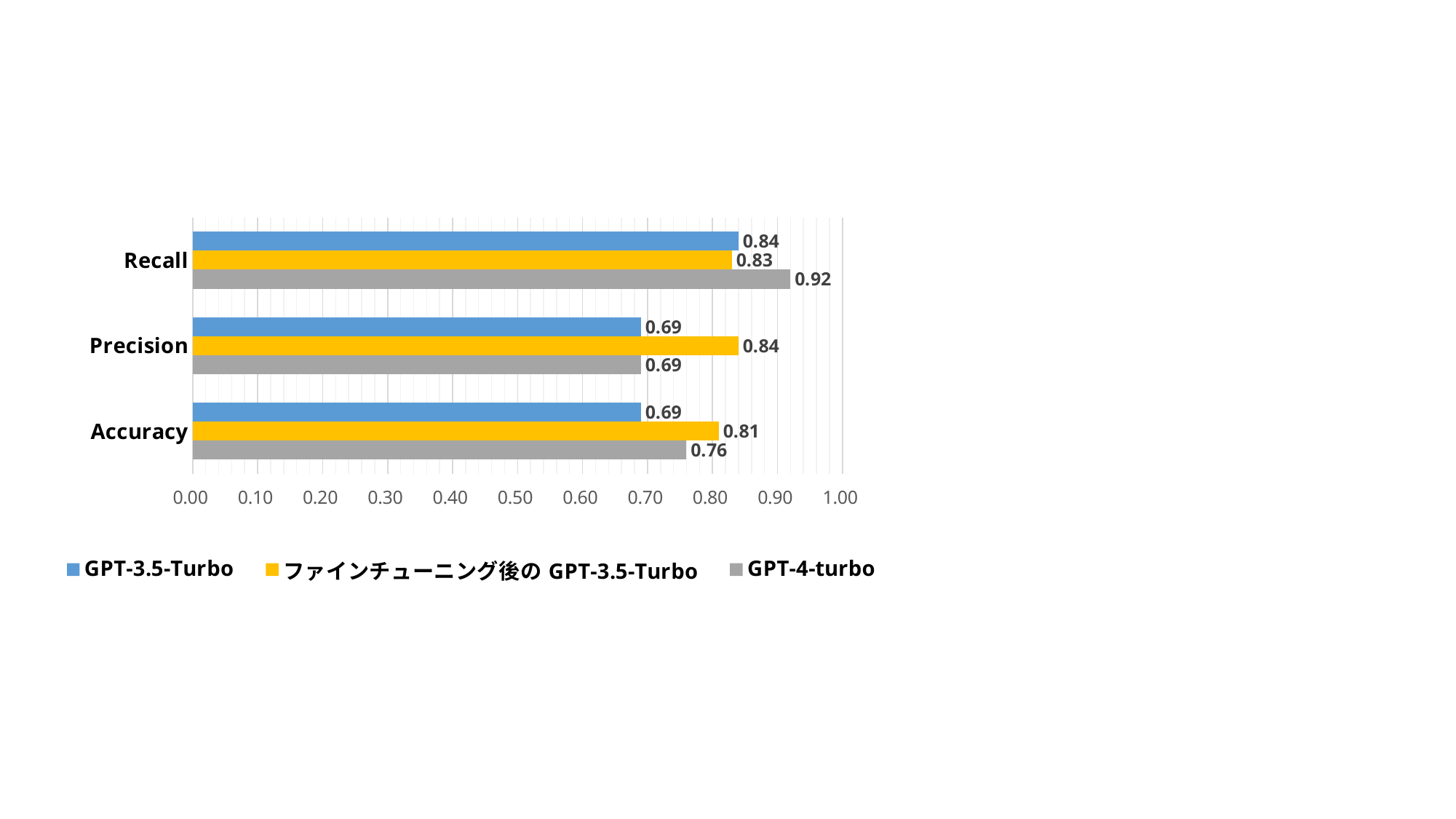
What is the Accuracy value for GPT-3.5-Turbo? 0.69 What kind of chart is shown on the slide? Bar chart What is the Recall value for GPT-4-turbo? 0.92 Which is larger: the Precision value for ファインチューニング後の GPT-3.5-Turbo or for GPT-4-turbo? ファインチューニング後の GPT-3.5-Turbo Which series has the highest Recall value? GPT-4-turbo What is the difference between the Accuracy values of ファインチューニング後の GPT-3.5-Turbo and GPT-3.5-Turbo? 0.12 How many series does the legend list? 3 What is the Precision value for ファインチューニング後の GPT-3.5-Turbo? 0.84 How many categories are shown on the vertical axis? 3 Which series has the lowest Accuracy value? GPT-3.5-Turbo What is the Accuracy value for GPT-4-turbo? 0.76 What is the difference between the Recall values of GPT-4-turbo and GPT-3.5-Turbo? 0.08